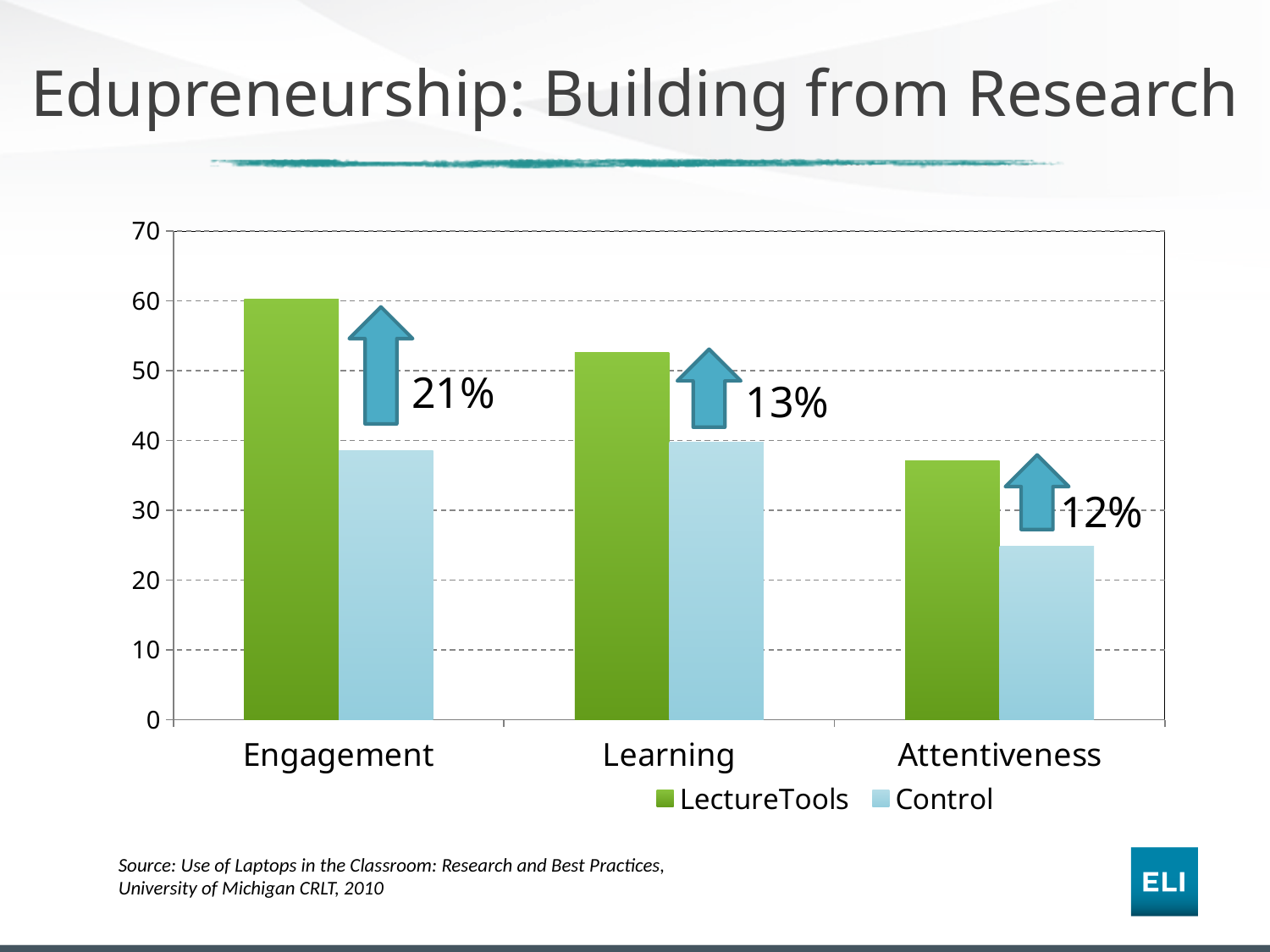
For Engagement, which is larger: the LectureTools bar or the Control bar? LectureTools What kind of chart is shown on the slide? bar chart Which category has the highest LectureTools bar? Engagement Do the LectureTools values rise or fall moving from Engagement to Attentiveness along the x axis? fall How many categories are shown on the x axis of the chart? 3 What are the two series named in the chart's legend? LectureTools and Control How many series does the chart's legend list? 2 Which category has the lowest Control bar? Attentiveness Is the LectureTools value for Engagement greater or less than 50? greater Is the LectureTools value for Attentiveness greater or less than 40? less Is the Control value for Attentiveness greater or less than 30? less What percentage increase is annotated with the arrow above the Engagement bars? 21%